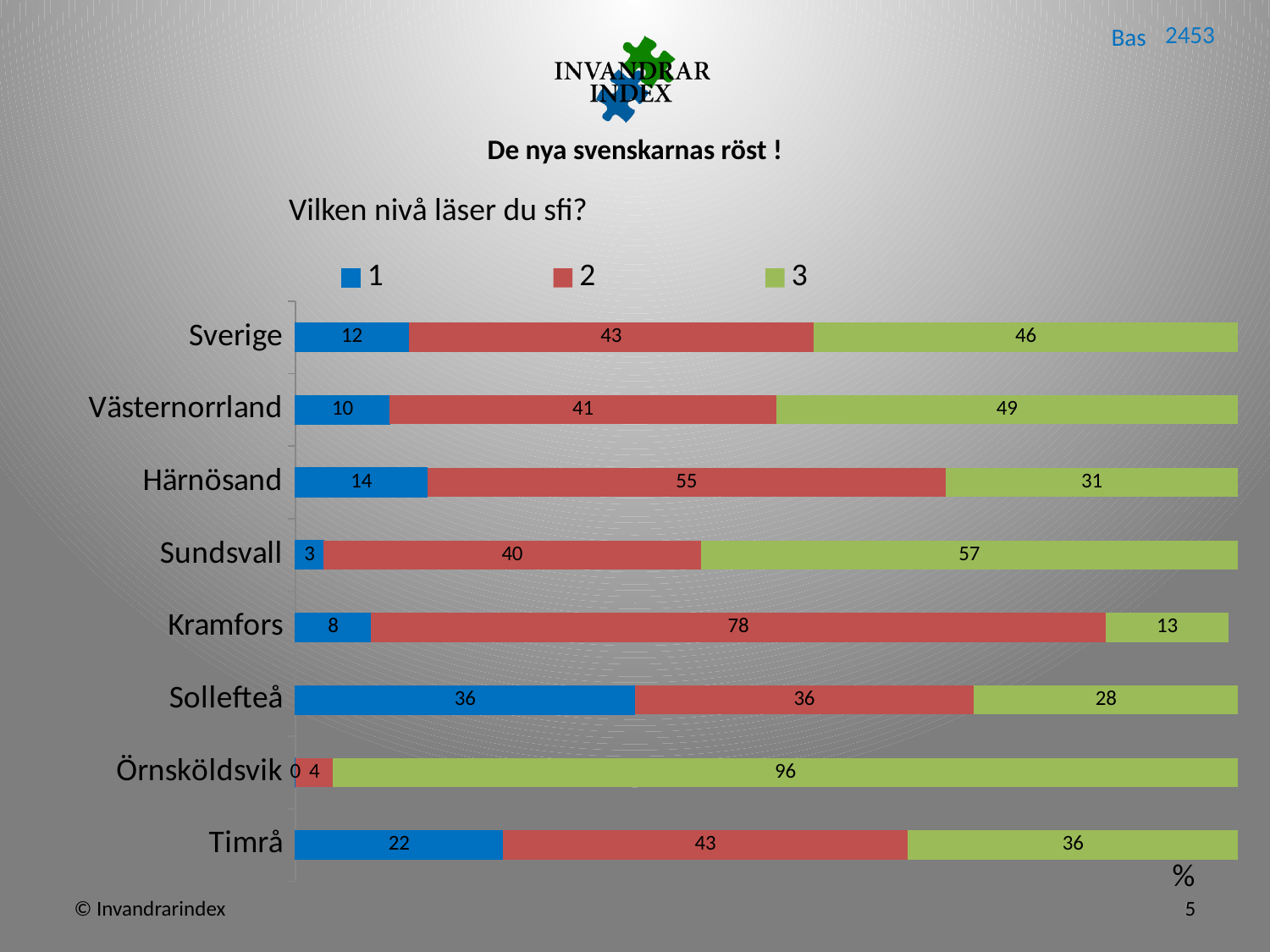
Which is larger: the series 1 value for Timrå or the series 1 value for Härnösand? Timrå What is the title of the chart? Vilken nivå läser du sfi? Which category has the lowest value for series 1? Örnsköldsvik What is the difference between the series 2 values for Kramfors and Sundsvall? 38 What is the total of the stacked bar for Sverige? 101 What is the value of series 3 for Örnsköldsvik? 96 Which category has the highest value for series 3? Örnsköldsvik How many categories (regions) are shown on the chart? 8 What is the value of series 2 for Kramfors? 78 What is the value of series 1 for Sollefteå? 36 How many series does the legend list? 3 What kind of chart is shown on the slide? stacked bar chart